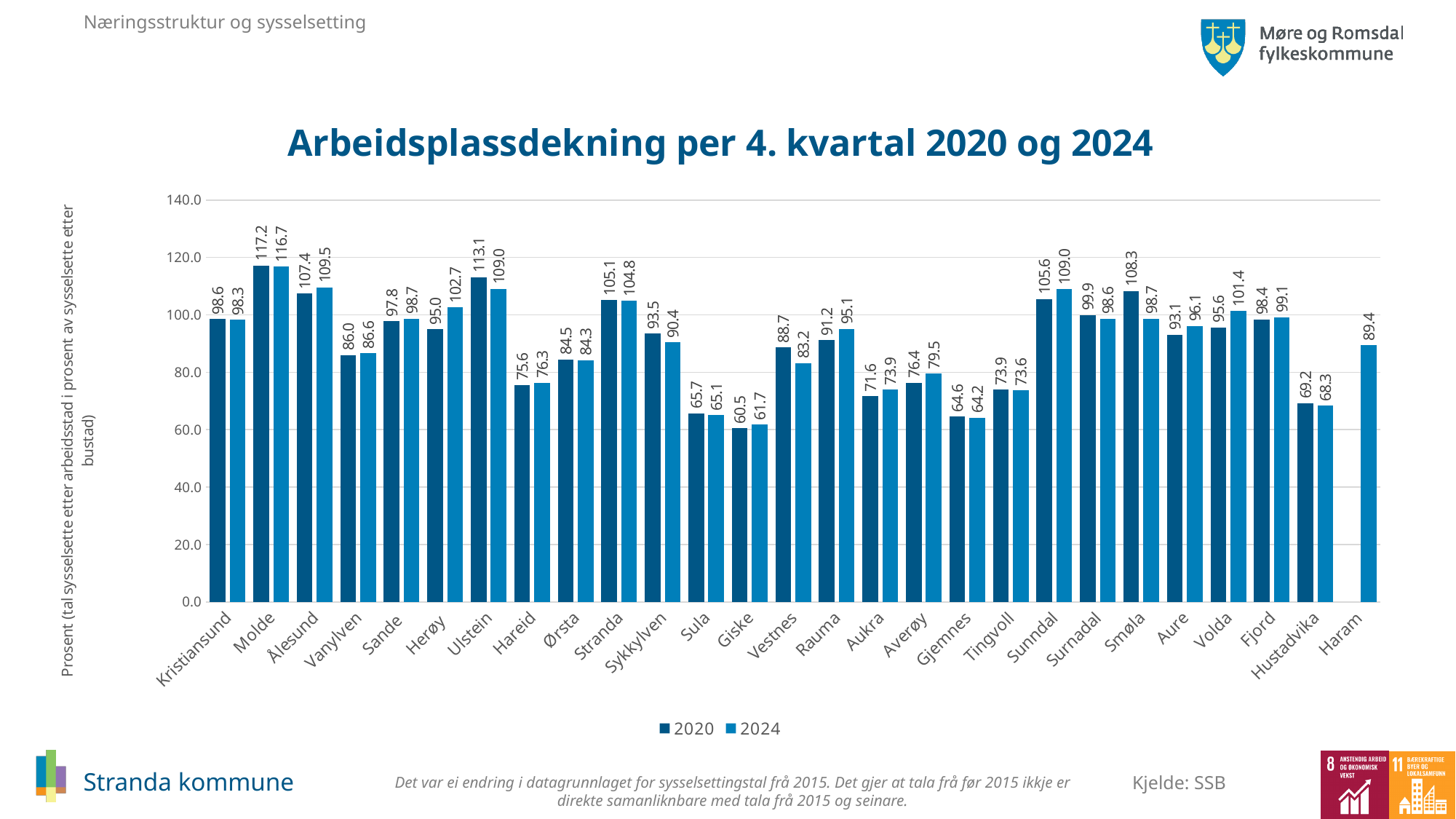
Which municipality has the lowest 2024 value? Giske Which municipality has the highest 2020 value? Molde What is the 2024 value for Volda? 101.4 How many series does the legend list? 2 What is the value for Haram in 2024? 89.4 How many municipalities are shown on the x axis? 27 Is the 2020 value for Sunndal greater or less than 100.0? greater What is the value for Stranda in 2020? 105.1 What type of chart is shown on the slide? Bar chart What is the difference between the 2024 and 2020 values for Herøy? 7.7 By how much did Smøla's value fall from 2020 to 2024? 9.6 Which is larger for Ulstein: the 2020 value or the 2024 value? 2020